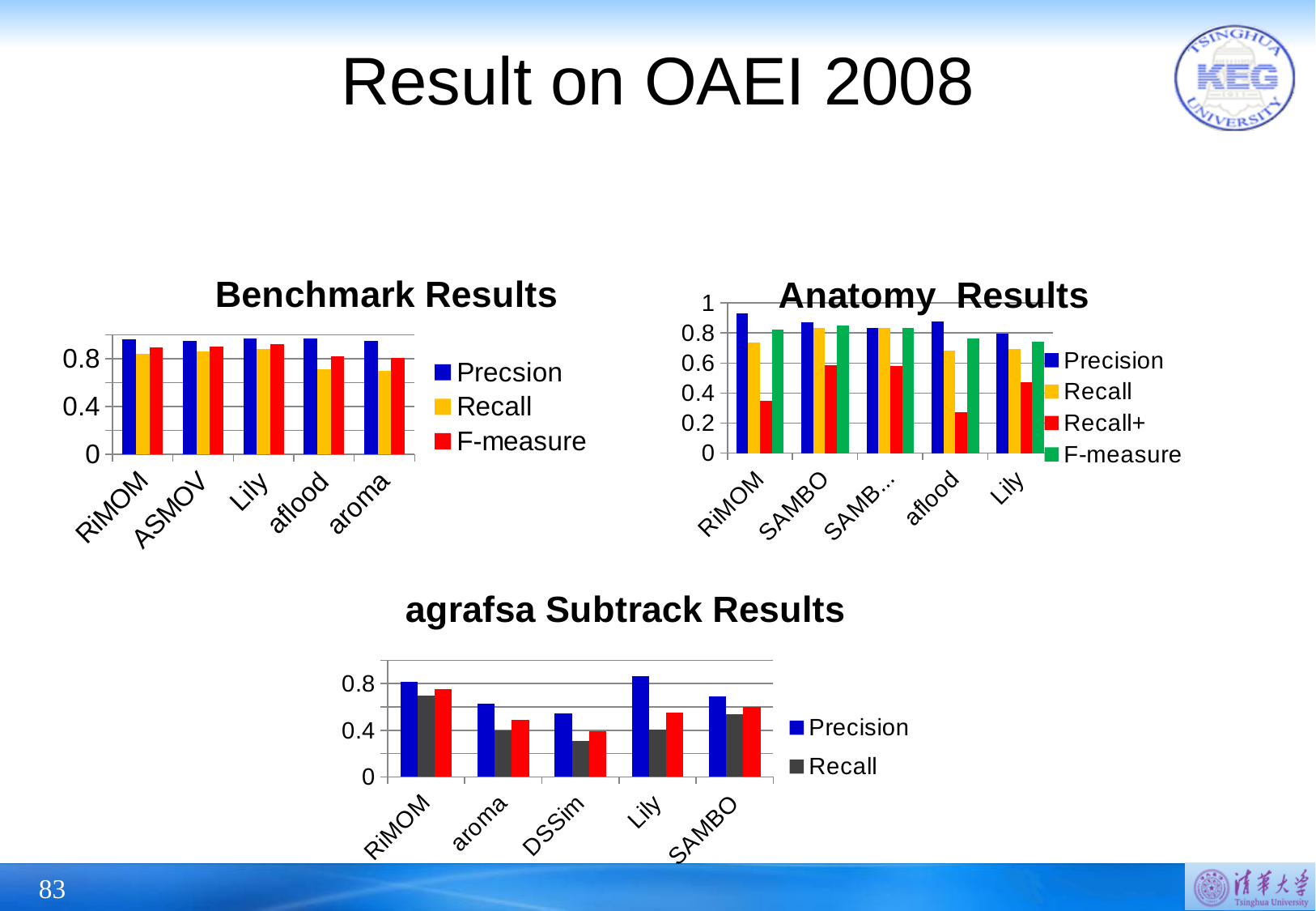
How many categories are shown on the x axis of the Benchmark Results chart? 5 In the agrafsa Subtrack Results chart, which category has the highest Precision value? Lily What kind of chart is the Benchmark Results chart? bar chart In the Benchmark Results chart, is the Precsion value for RiMOM greater or less than 0.8? greater How many series does the legend of the Anatomy Results chart list? 4 How many series does the legend of the Benchmark Results chart list? 3 In the agrafsa Subtrack Results chart, which category has the lowest Precision value? DSSim In the Anatomy Results chart, which is larger for RiMOM: Precision or Recall+? Precision In the Benchmark Results chart, is the Recall value for aflood greater or less than 0.8? less In the Anatomy Results chart, is the Recall+ value for RiMOM greater or less than 0.4? less In the Anatomy Results chart, which category has the lowest Recall+ value? aflood